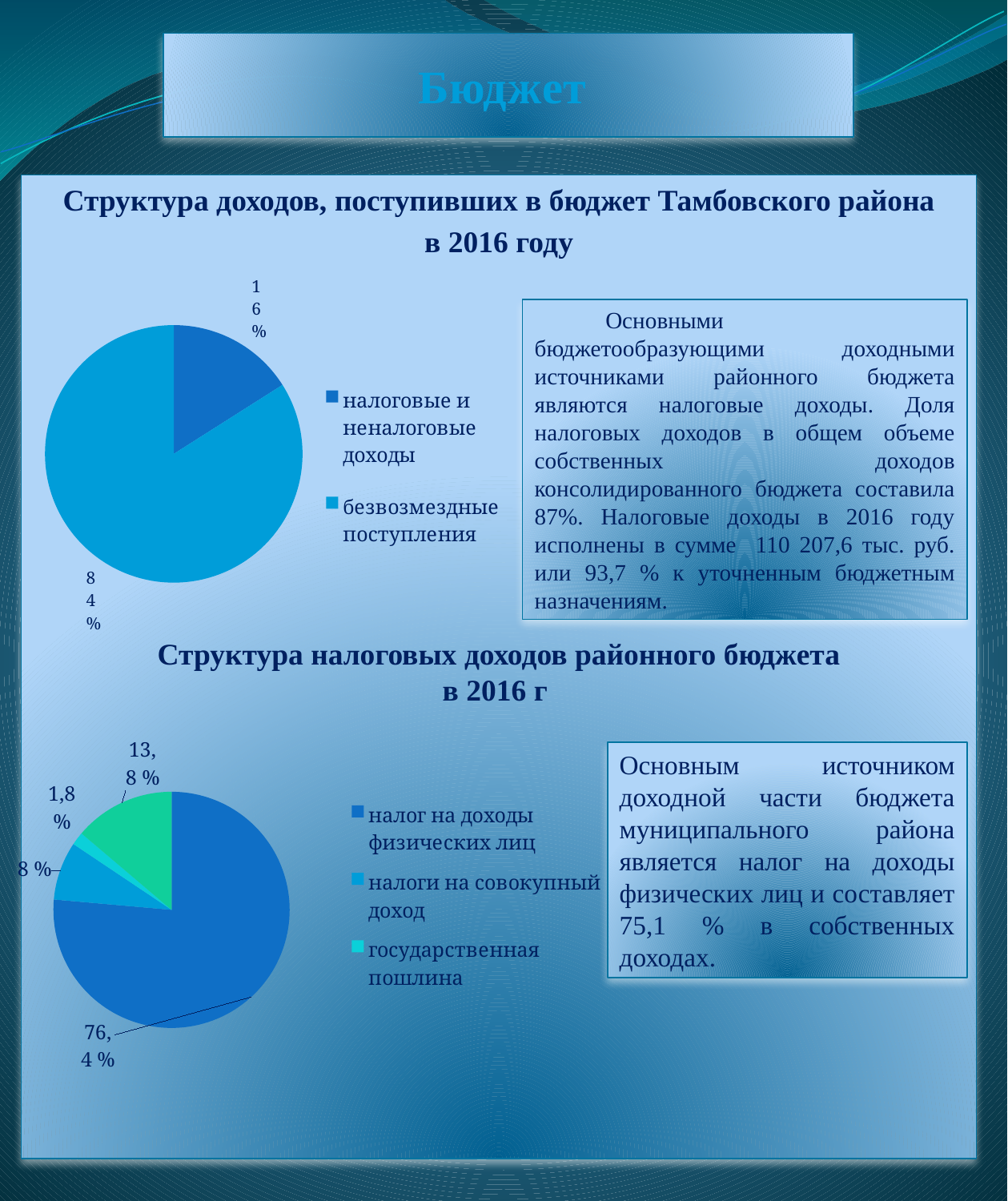
In the top chart 'Структура доходов, поступивших в бюджет Тамбовского района в 2016 году', how many entries does the legend list? 2 In the top chart 'Структура доходов, поступивших в бюджет Тамбовского района в 2016 году', what share is shown for 'безвозмездные поступления'? 84% In the bottom chart 'Структура налоговых доходов районного бюджета в 2016 г', how many entries does the legend list? 3 What type of chart is used in the top chart titled 'Структура доходов, поступивших в бюджет Тамбовского района в 2016 году'? pie chart In the top chart 'Структура доходов, поступивших в бюджет Тамбовского района в 2016 году', what share is shown for 'налоговые и неналоговые доходы'? 16% In the bottom chart 'Структура налоговых доходов районного бюджета в 2016 г', which is larger: 'налог на доходы физических лиц' or 'государственная пошлина'? налог на доходы физических лиц In the top chart 'Структура доходов, поступивших в бюджет Тамбовского района в 2016 году', what is the difference in percentage points between 'безвозмездные поступления' and 'налоговые и неналоговые доходы'? 68 In the bottom chart 'Структура налоговых доходов районного бюджета в 2016 г', what share is shown for 'государственная пошлина'? 1,8 % In the top chart 'Структура доходов, поступивших в бюджет Тамбовского района в 2016 году', which category has the largest slice? безвозмездные поступления In the bottom chart 'Структура налоговых доходов районного бюджета в 2016 г', which category has the largest slice? налог на доходы физических лиц In the bottom chart 'Структура налоговых доходов районного бюджета в 2016 г', what share is shown for 'налог на доходы физических лиц'? 76,4 %